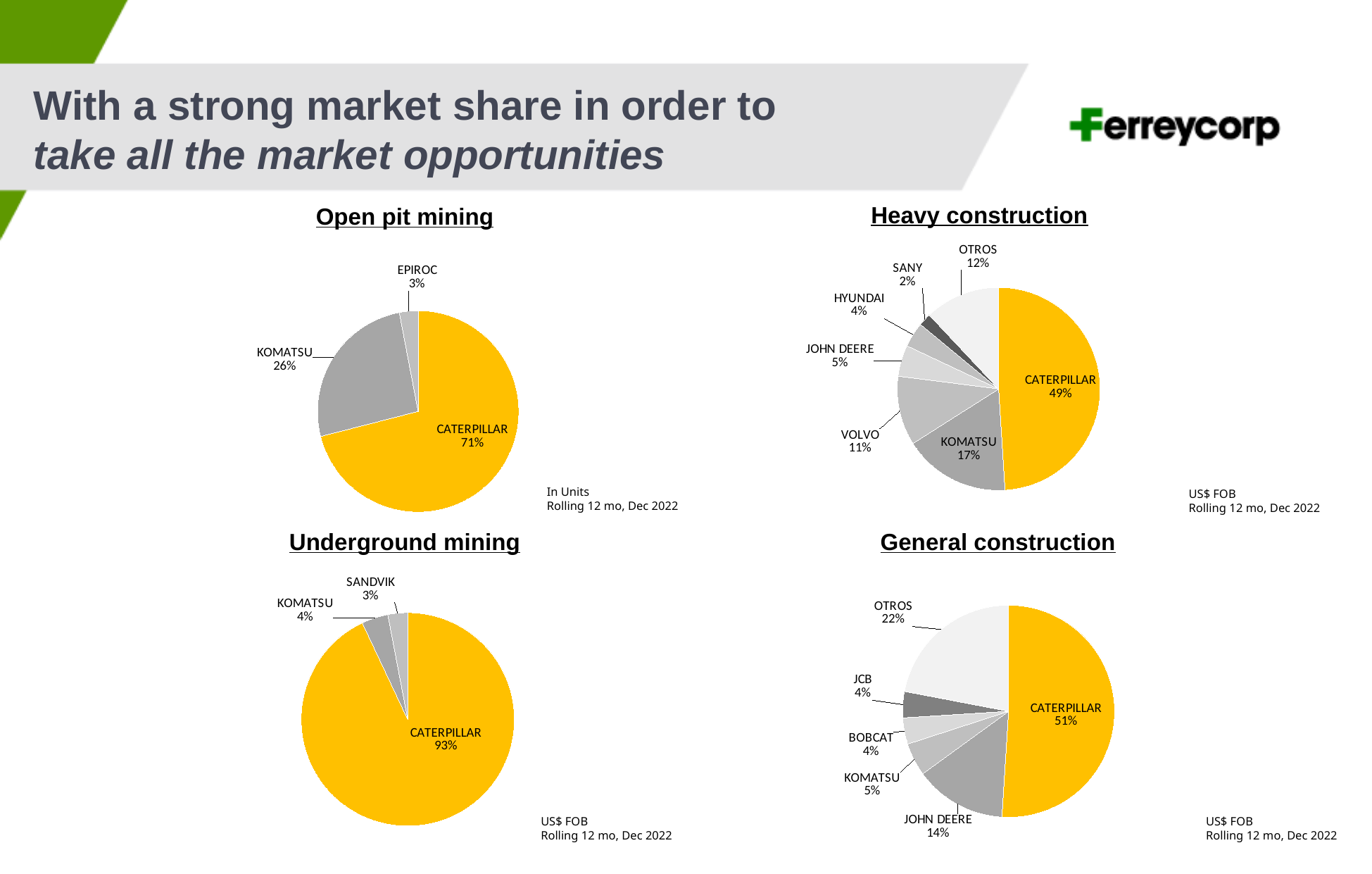
What type of chart is used for Open pit mining? Pie chart In the Underground mining chart, what share does CATERPILLAR hold? 93% What unit is stated below the Open pit mining chart? In Units In the General construction chart, which category has the largest share? CATERPILLAR In the Heavy construction chart, which is larger: KOMATSU's share or OTROS's share? KOMATSU How many slices does the Underground mining pie chart have? 3 In the Heavy construction chart, which brand has the smallest share? SANY How many slices does the Heavy construction pie chart have? 7 In the Heavy construction chart, what share does VOLVO hold? 11% In the Open pit mining chart, what share does KOMATSU hold? 26% In the General construction chart, what share does JOHN DEERE hold? 14% In the Open pit mining chart, what is the difference between CATERPILLAR's share and KOMATSU's share? 45 percentage points